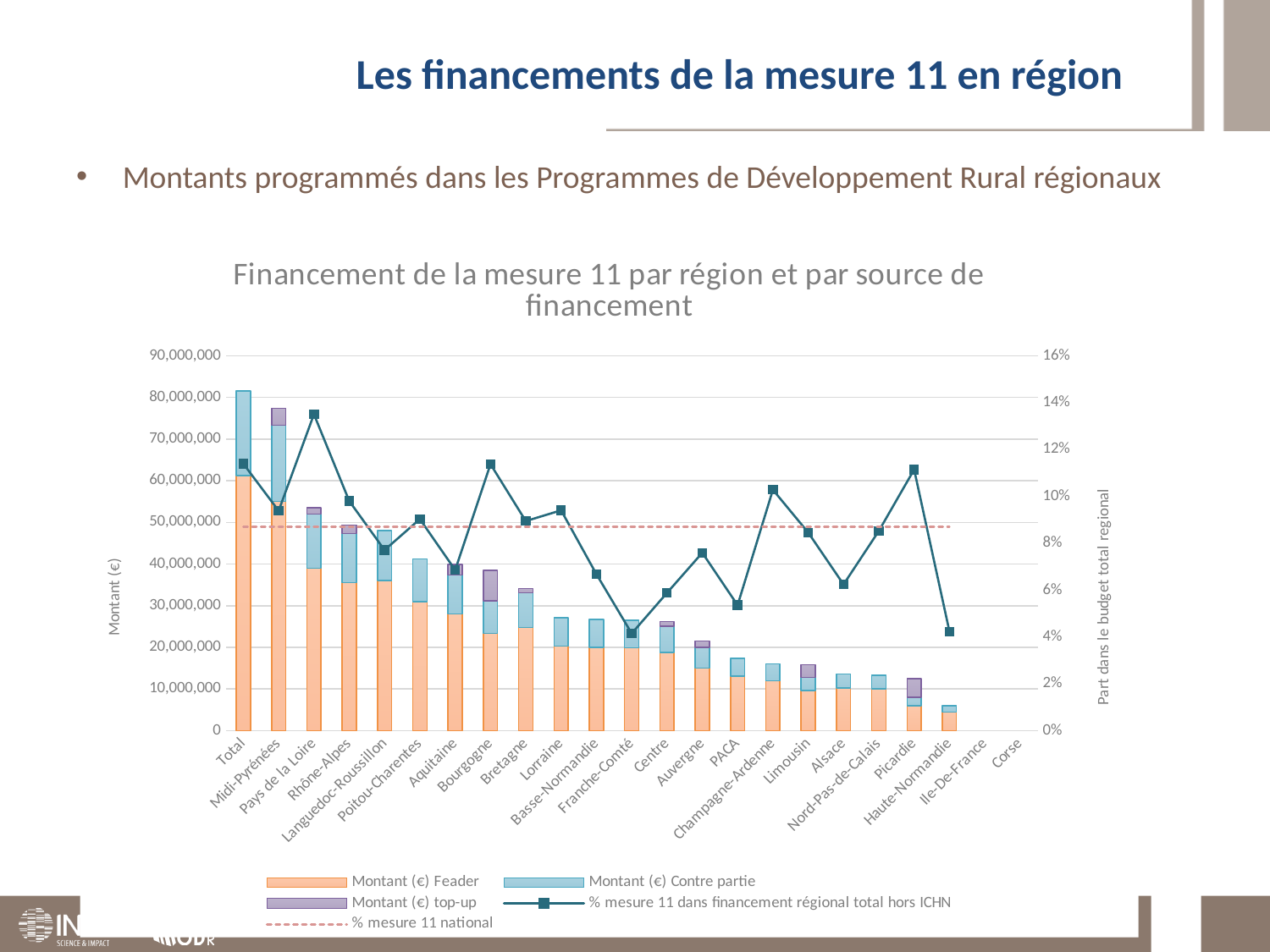
What is the label of the right-hand (secondary) vertical axis? Part dans le budget total regional What kind of chart is shown on the slide? A stacked bar chart combined with a line chart Is the total stacked bar for Haute-Normandie greater or less than 10,000,000? less Is the dashed '% mesure 11 national' line greater or less than 8%? greater Is the '% mesure 11 dans financement régional total hors ICHN' value for Pays de la Loire greater or less than 12%? greater How many series does the chart legend list? 5 Which has the taller stacked bar, Bourgogne or Bretagne? Bourgogne Excluding the 'Total' category, which region has the tallest stacked bar? Midi-Pyrénées Which category has the highest value on the '% mesure 11 dans financement régional total hors ICHN' line? Pays de la Loire Which has the higher '% mesure 11 dans financement régional total hors ICHN' value, Champagne-Ardenne or Limousin? Champagne-Ardenne How many categories are shown on the x axis of the chart? 23